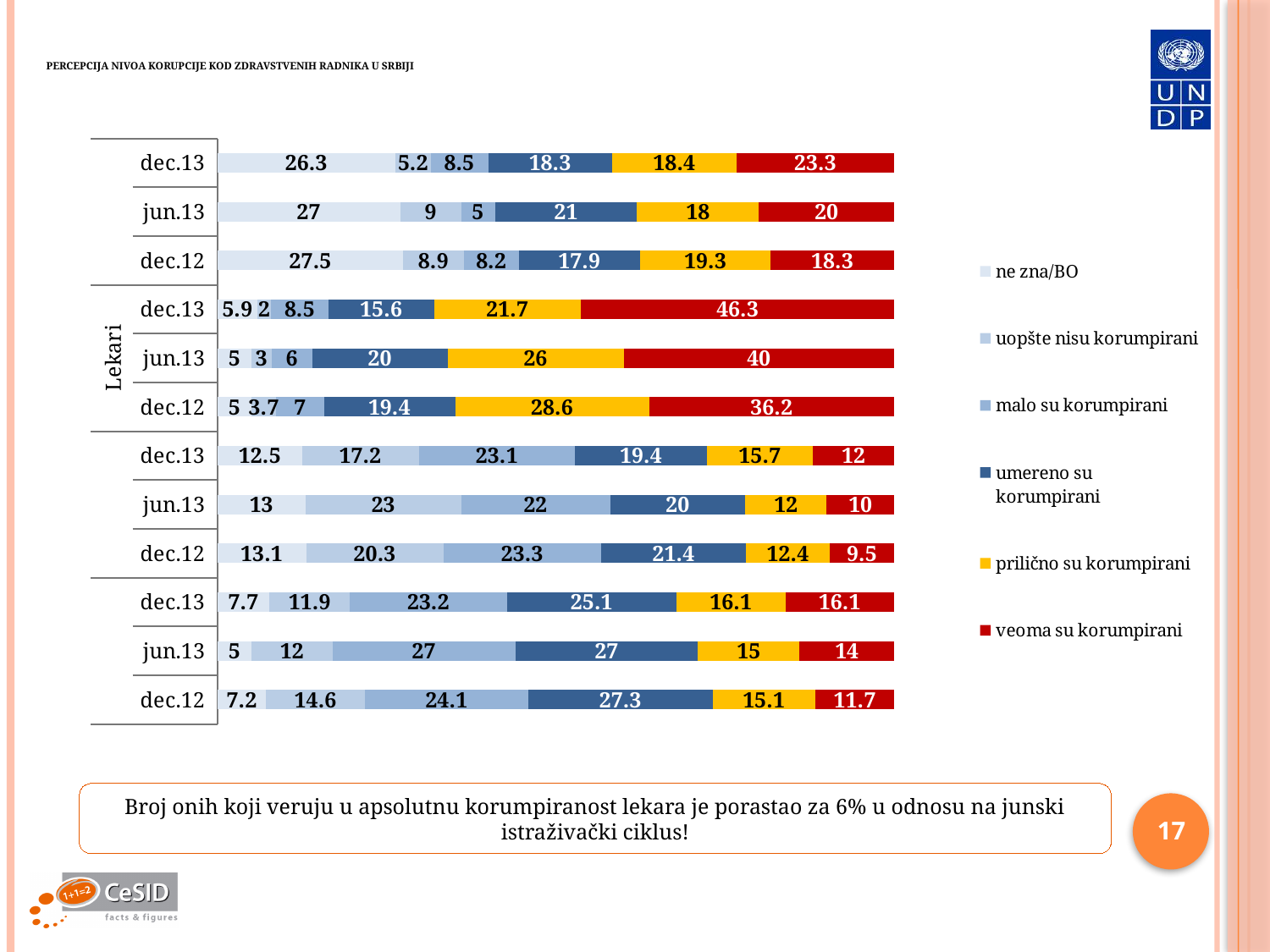
In the Lekari group, what is the value for 'prilično su korumpirani' in jun.13? 26 In the Lekari group, what is the value for 'ne zna/BO' in dec.13? 5.9 How many series does the legend list? 6 In the Lekari group for dec.12, which is larger: 'prilično su korumpirani' or 'umereno su korumpirani'? prilično su korumpirani In the Lekari group, what is the value for 'veoma su korumpirani' in dec.13? 46.3 In the Lekari group, what is the value for 'umereno su korumpirani' in dec.12? 19.4 In the Lekari group, does the value for 'veoma su korumpirani' rise or fall from dec.12 to dec.13? Rises How many bars are there in the Lekari group? 3 What kind of chart is shown on the slide? Stacked bar chart What is the total of the Lekari jun.13 stacked bar? 100 In the Lekari group, by how much did 'veoma su korumpirani' change from jun.13 to dec.13? 6.3 In the Lekari group for dec.13, which category has the largest value? veoma su korumpirani